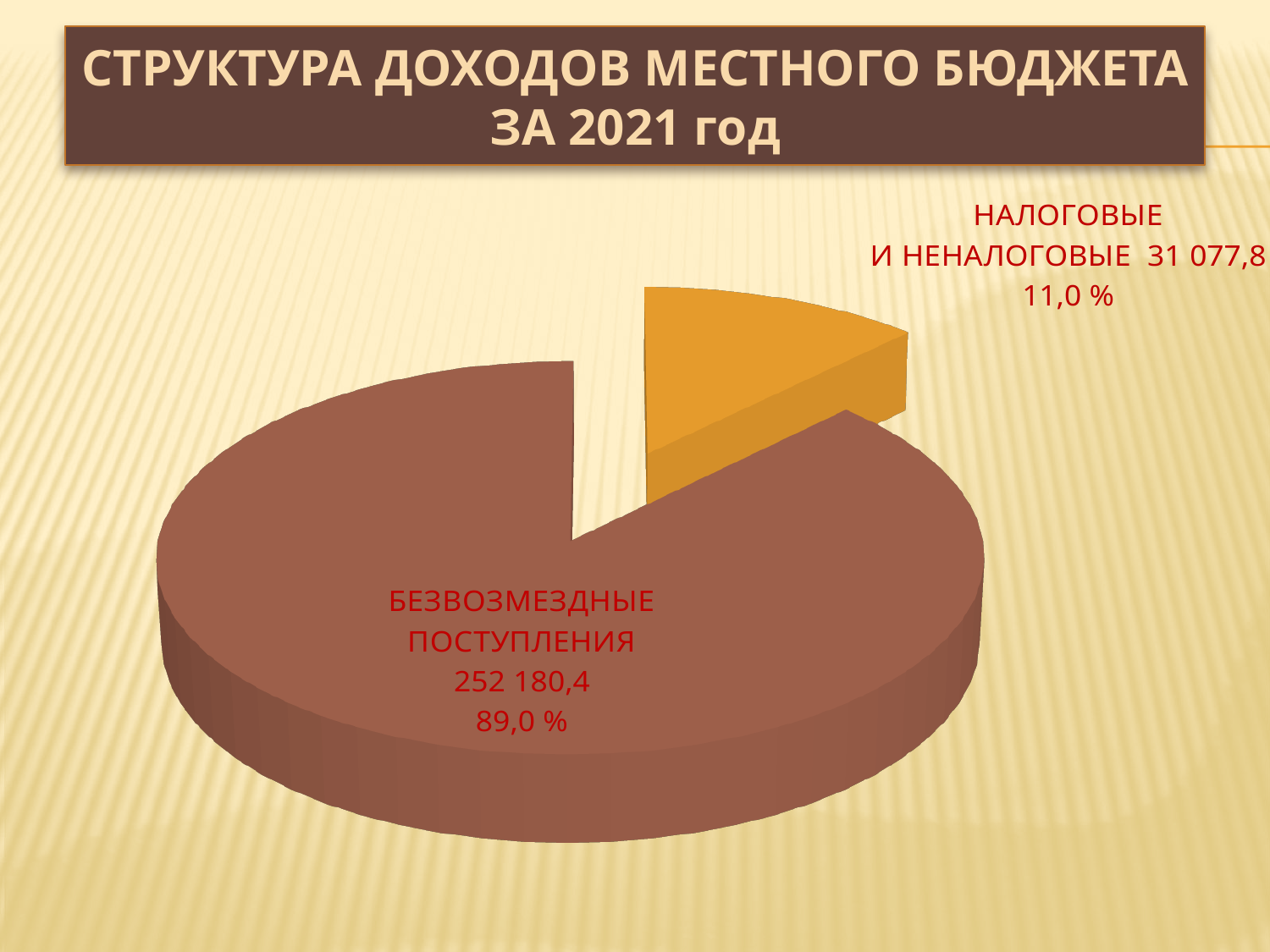
Which slice is the smallest? НАЛОГОВЫЕ И НЕНАЛОГОВЫЕ What is the value for НАЛОГОВЫЕ И НЕНАЛОГОВЫЕ? 31 077,8 What is the difference in percentage share between БЕЗВОЗМЕЗДНЫЕ ПОСТУПЛЕНИЯ and НАЛОГОВЫЕ И НЕНАЛОГОВЫЕ? 78,0 % What colour is the slice for НАЛОГОВЫЕ И НЕНАЛОГОВЫЕ? Orange Which is larger, БЕЗВОЗМЕЗДНЫЕ ПОСТУПЛЕНИЯ or НАЛОГОВЫЕ И НЕНАЛОГОВЫЕ? БЕЗВОЗМЕЗДНЫЕ ПОСТУПЛЕНИЯ What is the value for БЕЗВОЗМЕЗДНЫЕ ПОСТУПЛЕНИЯ? 252 180,4 What share of the pie does БЕЗВОЗМЕЗДНЫЕ ПОСТУПЛЕНИЯ represent? 89,0 % What share of the pie does НАЛОГОВЫЕ И НЕНАЛОГОВЫЕ represent? 11,0 % What kind of chart is shown on the slide? Pie chart What is the title of the chart? СТРУКТУРА ДОХОДОВ МЕСТНОГО БЮДЖЕТА ЗА 2021 год Which slice is the largest? БЕЗВОЗМЕЗДНЫЕ ПОСТУПЛЕНИЯ How many slices does the pie chart have? 2